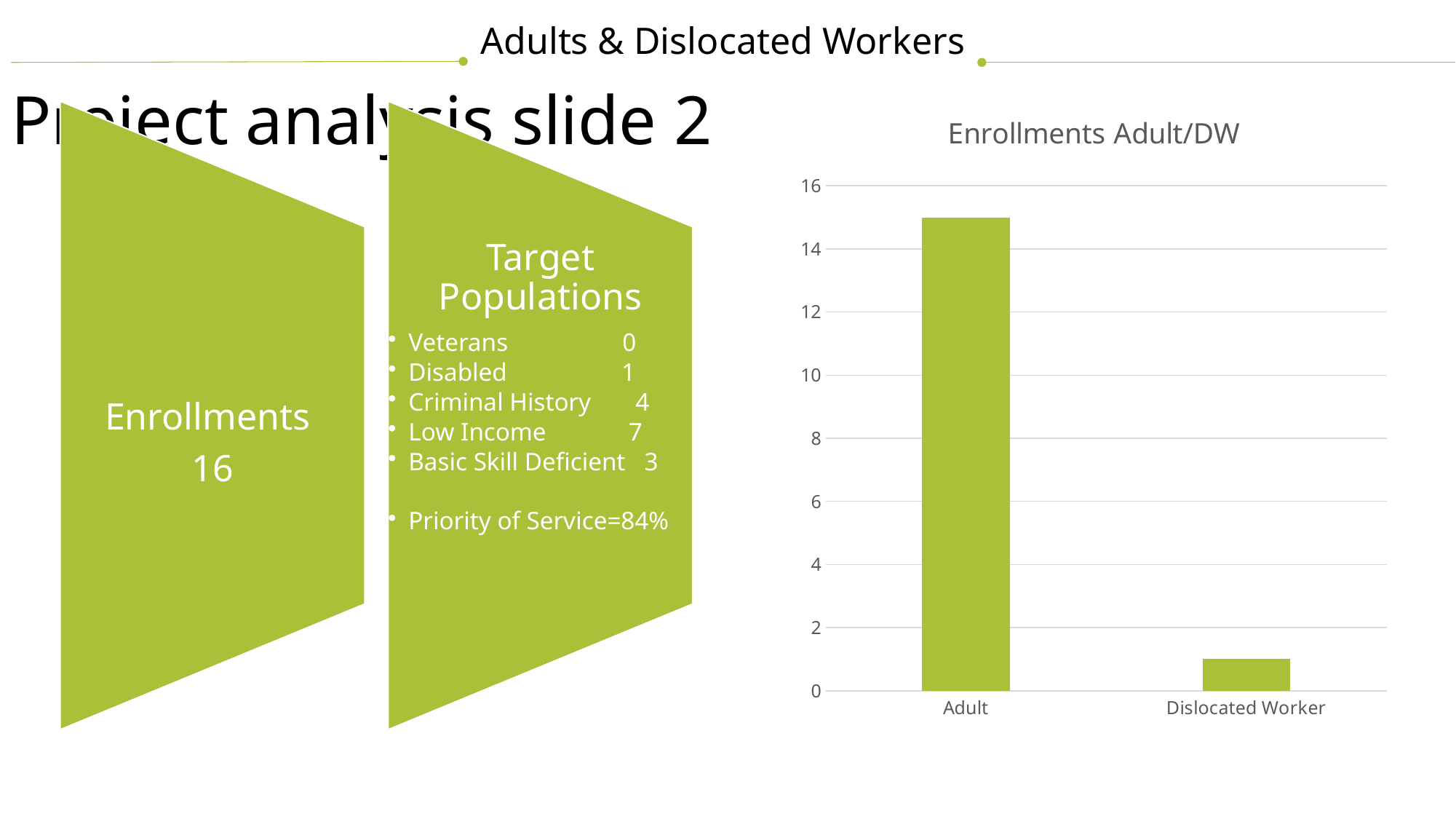
Is the value for Adult greater or less than 10? greater Which is larger, the value for Adult or the value for Dislocated Worker? Adult Is the value for Adult greater or less than 16? less Is the value for Dislocated Worker greater or less than 2? less Which category has the highest value in the chart? Adult What is the highest value shown on the chart's vertical axis? 16 What kind of chart is shown on the slide? bar chart What is the title of the chart? Enrollments Adult/DW Which category has the lowest value in the chart? Dislocated Worker Do the values rise or fall moving from Adult to Dislocated Worker along the x axis? fall How many categories are plotted in the chart? 2